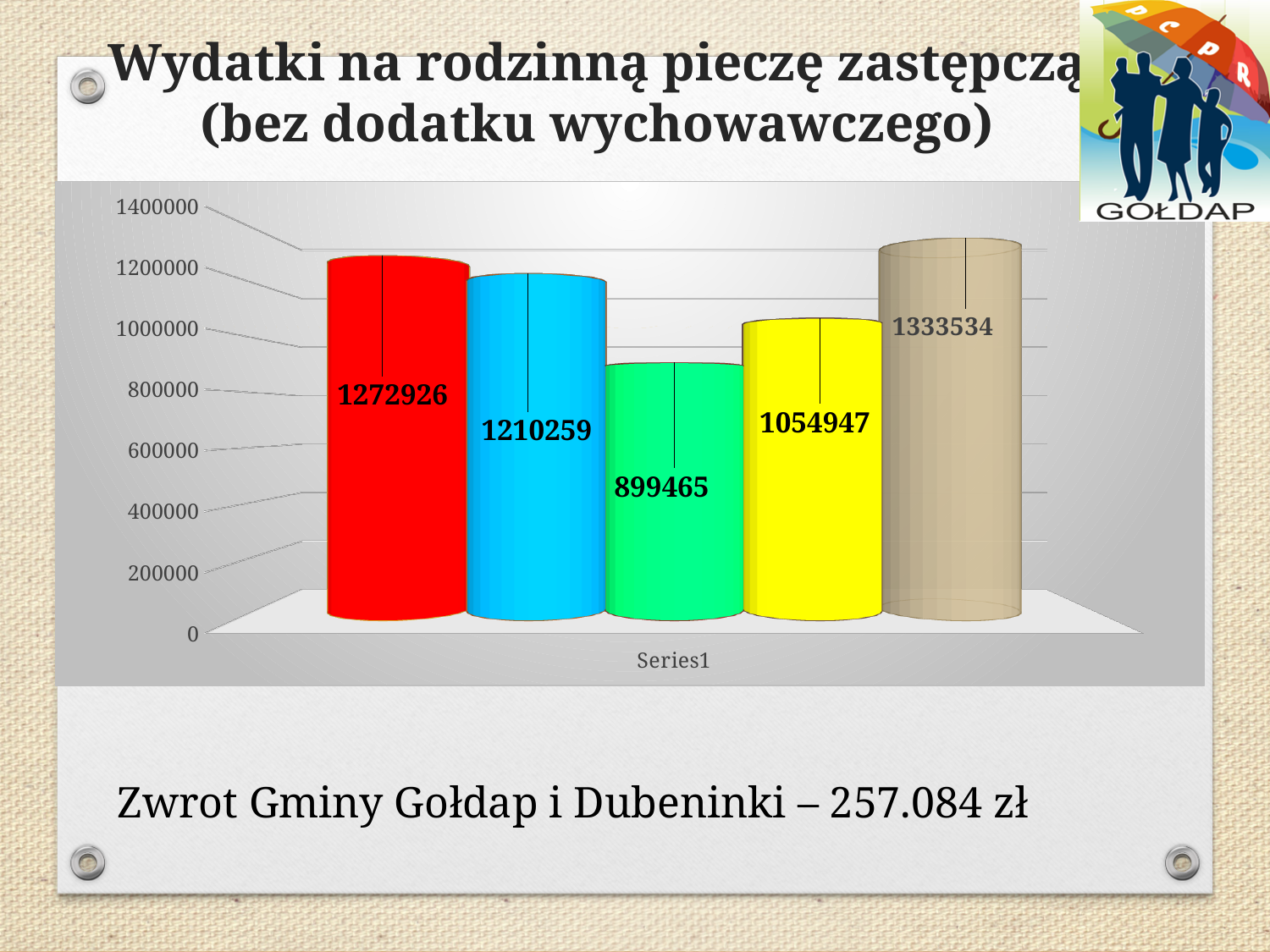
What is the value shown on the yellow bar (fourth from the left)? 1054947 Which bar has the highest value, and what is it? The rightmost (tan/brown) bar, 1333534 What is the value shown on the green bar (middle bar)? 899465 Which bar has the lowest value, and what is it? The middle (green) bar, 899465 How many bars are plotted in the chart? 5 What is the title of the chart on the slide? Wydatki na rodzinną pieczę zastępczą (bez dodatku wychowawczego) What is the value shown on the red bar (first from the left)? 1272926 Is the value of the green bar greater or less than 1000000? less What is the difference between the red bar (1272926) and the blue bar (1210259)? 62667 Which is larger, the value of the blue bar or the value of the yellow bar? The blue bar (1210259) What is the difference between the highest bar (1333534) and the lowest bar (899465)? 434069 What kind of chart is shown on the slide? bar chart